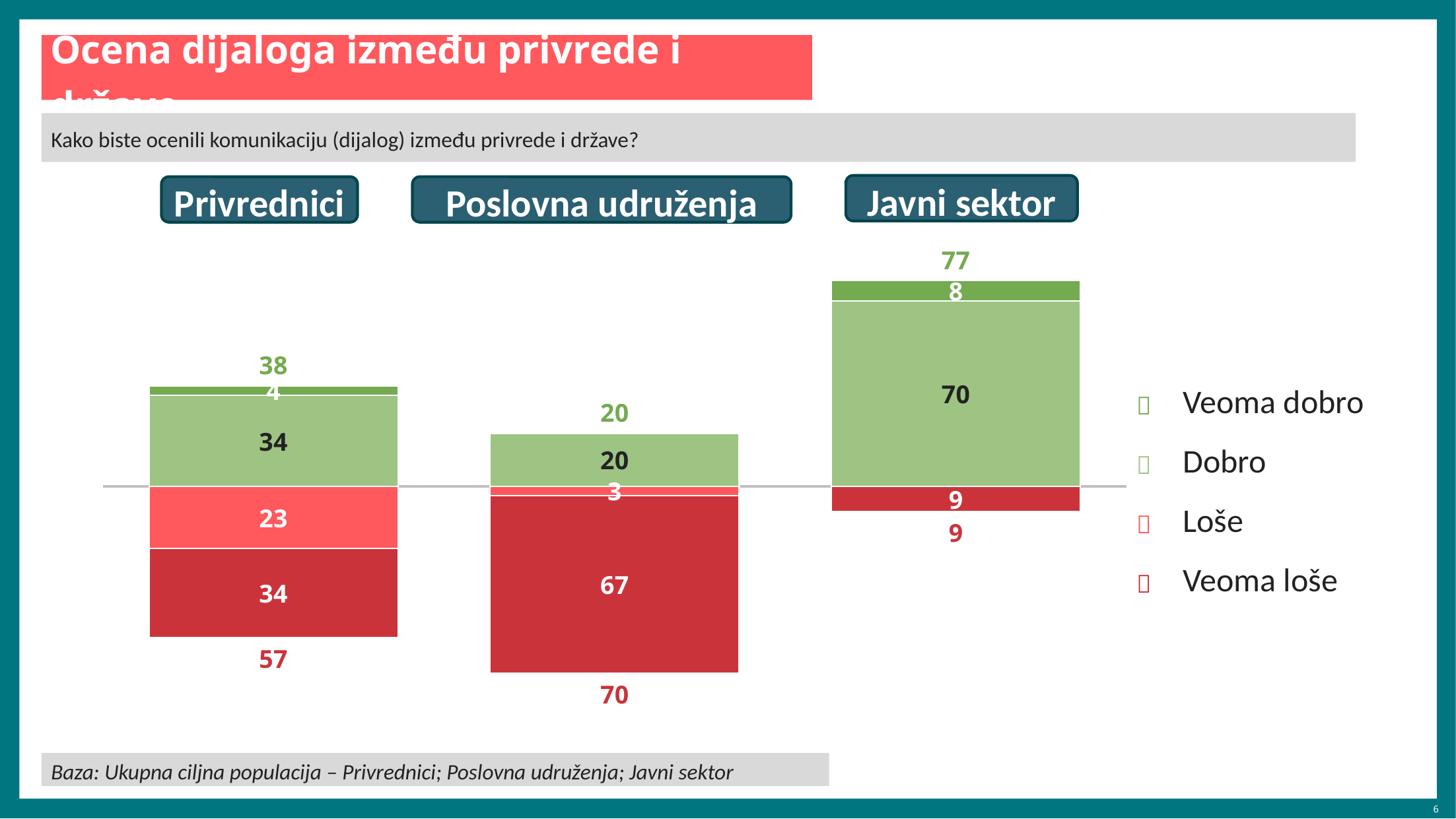
What is the 'Loše' value for Privrednici? 23 What is the combined negative (Loše + Veoma loše) total shown for Poslovna udruženja? 70 What is the combined positive (Veoma dobro + Dobro) total shown for Javni sektor? 77 What is the difference between the 'Veoma loše' values for Poslovna udruženja and Privrednici? 33 How many groups (categories) are shown in the chart? 3 How many entries does the legend list? 4 Which group has the highest combined positive rating? Javni sektor What is the 'Veoma loše' value for Poslovna udruženja? 67 What is the 'Dobro' value for Javni sektor? 70 What is the 'Dobro' value for Privrednici? 34 What kind of chart is shown on the slide? stacked bar chart Which group has the lowest combined negative rating? Javni sektor